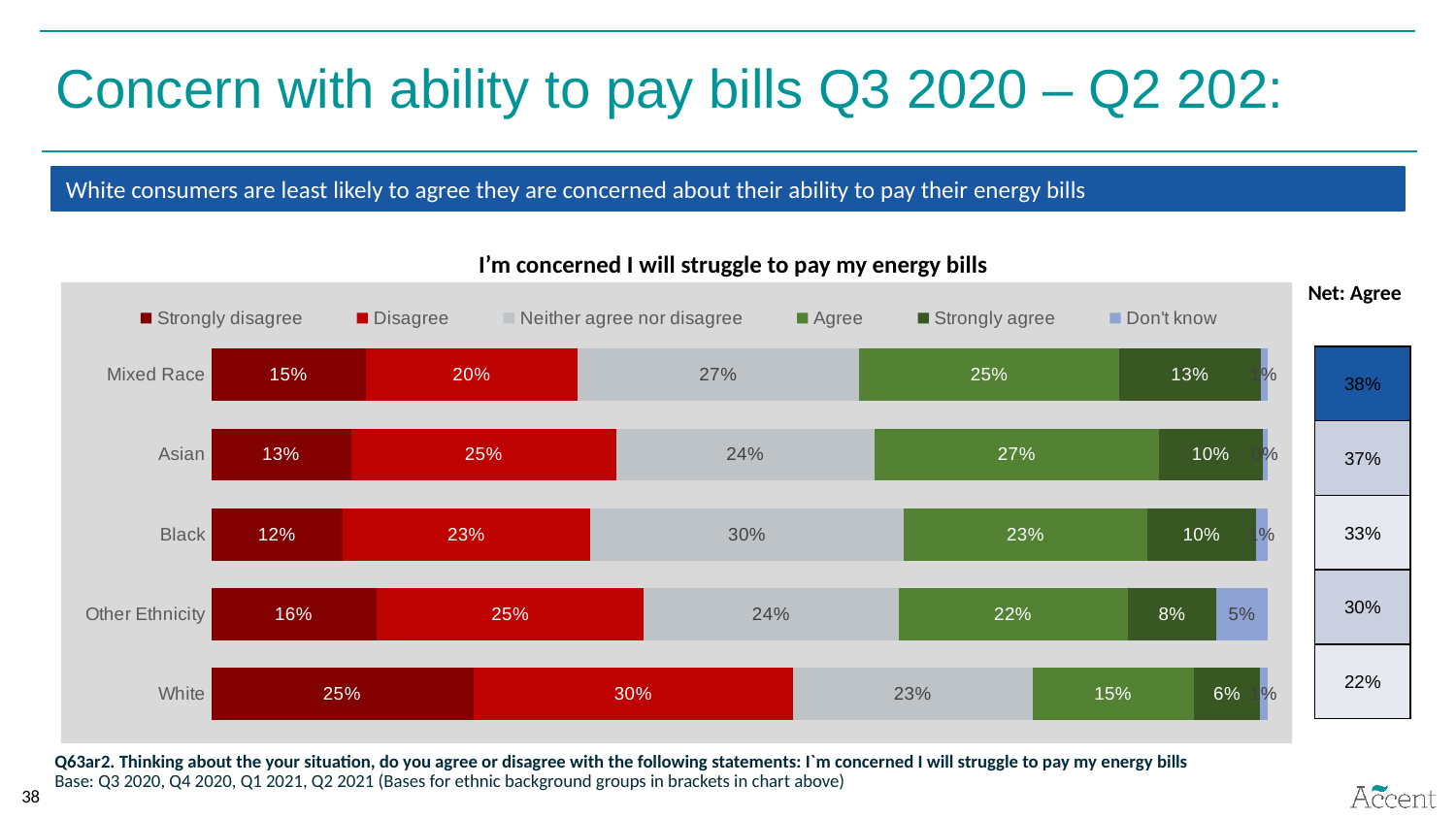
What is the difference between the 'Disagree' values for White and Mixed Race? 10% What is the 'Don't know' value for Other Ethnicity? 5% How many series does the legend list? 6 What is the Net: Agree value for Black? 33% How many ethnic groups are plotted in the chart? 5 What type of chart is shown on the slide? Stacked bar chart What is the 'Neither agree nor disagree' value for Black? 30% Which group has the lowest 'Strongly agree' value? White What is the 'Agree' value for Asian? 27% What is the 'Strongly disagree' value for White? 25% Which is larger, the 'Agree' value for Mixed Race or for Black? Mixed Race Which group has the highest 'Strongly disagree' value? White